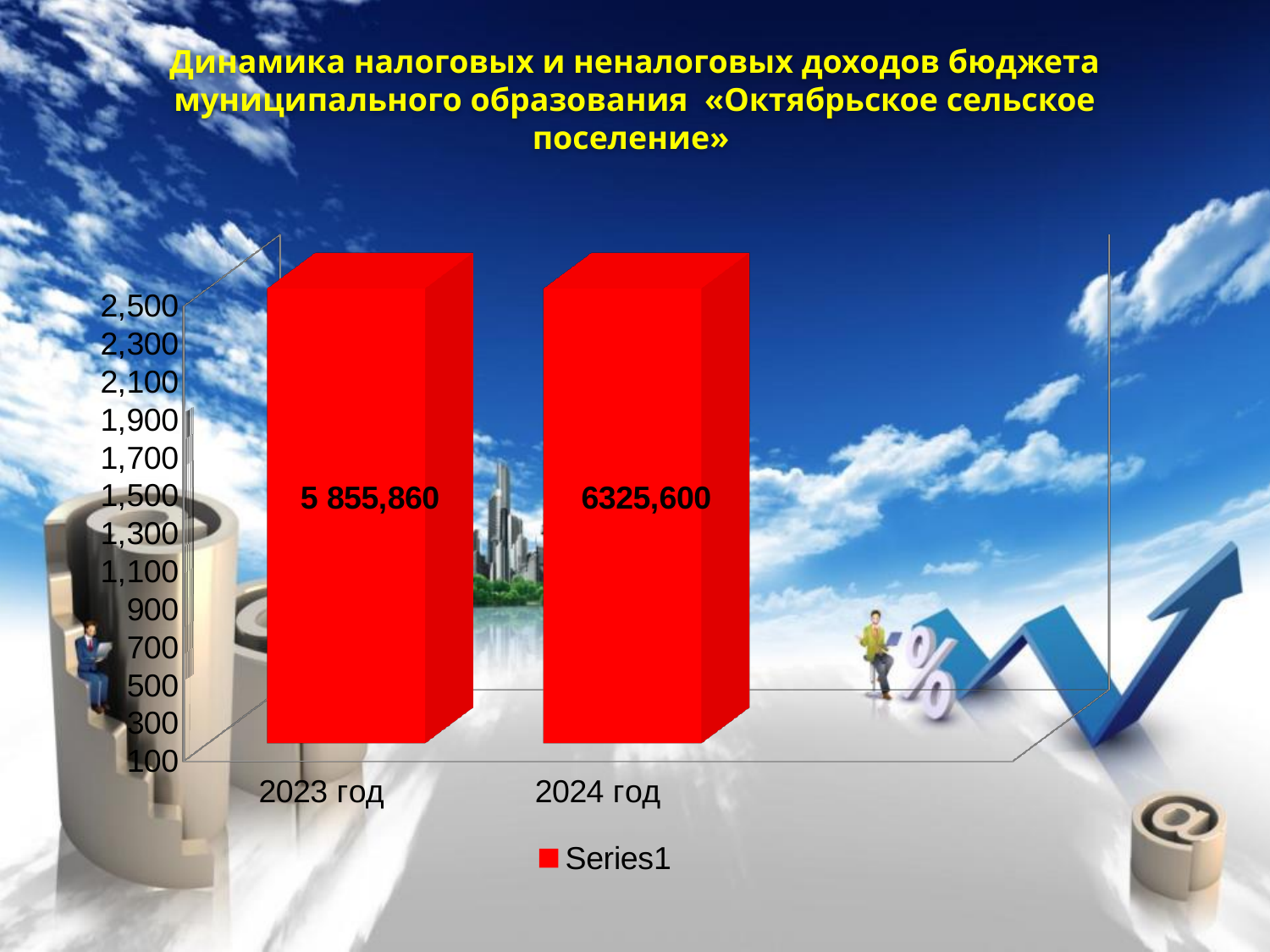
Is the value for 2023 год greater or less than 2,500? greater What kind of chart is shown on the slide? bar chart Do the values rise or fall from 2023 год to 2024 год? rise Which is larger, the value for 2023 год or the value for 2024 год? 2024 год Which year has the lowest value? 2023 год What is the name of the series shown in the legend? Series1 Which year has the highest value? 2024 год What is the value for 2023 год? 5 855,860 What is the value for 2024 год? 6325,600 How many series does the legend list? 1 How many categories are shown on the x axis? 2 What is the difference between the values for 2024 год and 2023 год? 469,740